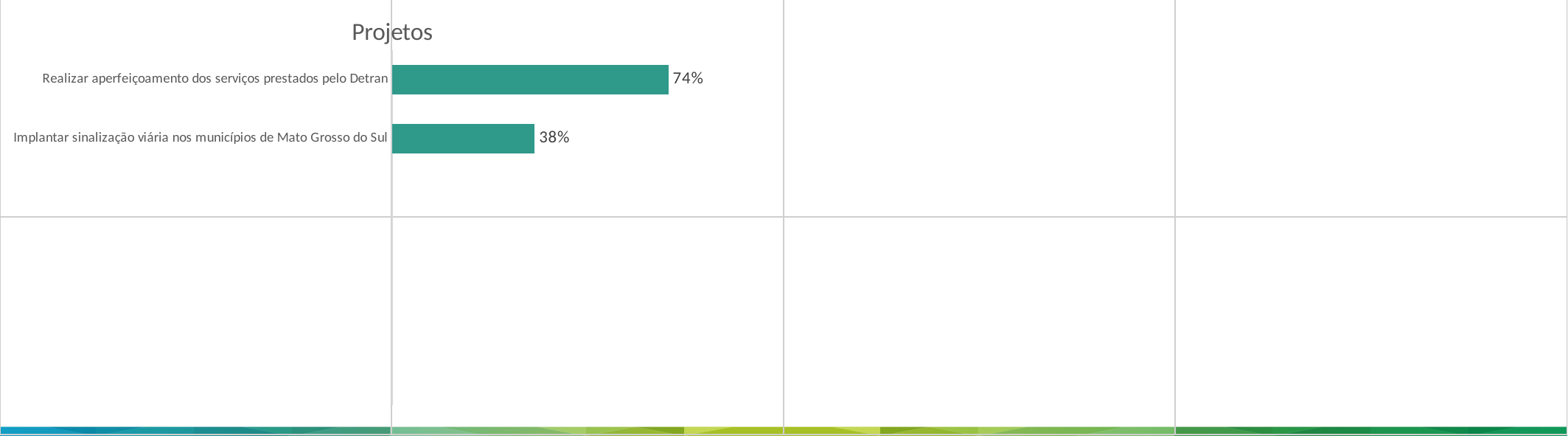
What is the value for "Implantar sinalização viária nos municípios de Mato Grosso do Sul"? 38% What is the value for "Realizar aperfeiçoamento dos serviços prestados pelo Detran"? 74% Which project has the lowest value? Implantar sinalização viária nos municípios de Mato Grosso do Sul What colour are the bars in the chart? Teal green What kind of chart is shown on the slide? Bar chart What is the difference between the values for "Realizar aperfeiçoamento dos serviços prestados pelo Detran" and "Implantar sinalização viária nos municípios de Mato Grosso do Sul"? 36% Which is larger: the value for "Implantar sinalização viária nos municípios de Mato Grosso do Sul" or the value for "Realizar aperfeiçoamento dos serviços prestados pelo Detran"? Realizar aperfeiçoamento dos serviços prestados pelo Detran What is the title of the chart? Projetos How many projects are plotted in the chart? 2 Which project has the highest value? Realizar aperfeiçoamento dos serviços prestados pelo Detran